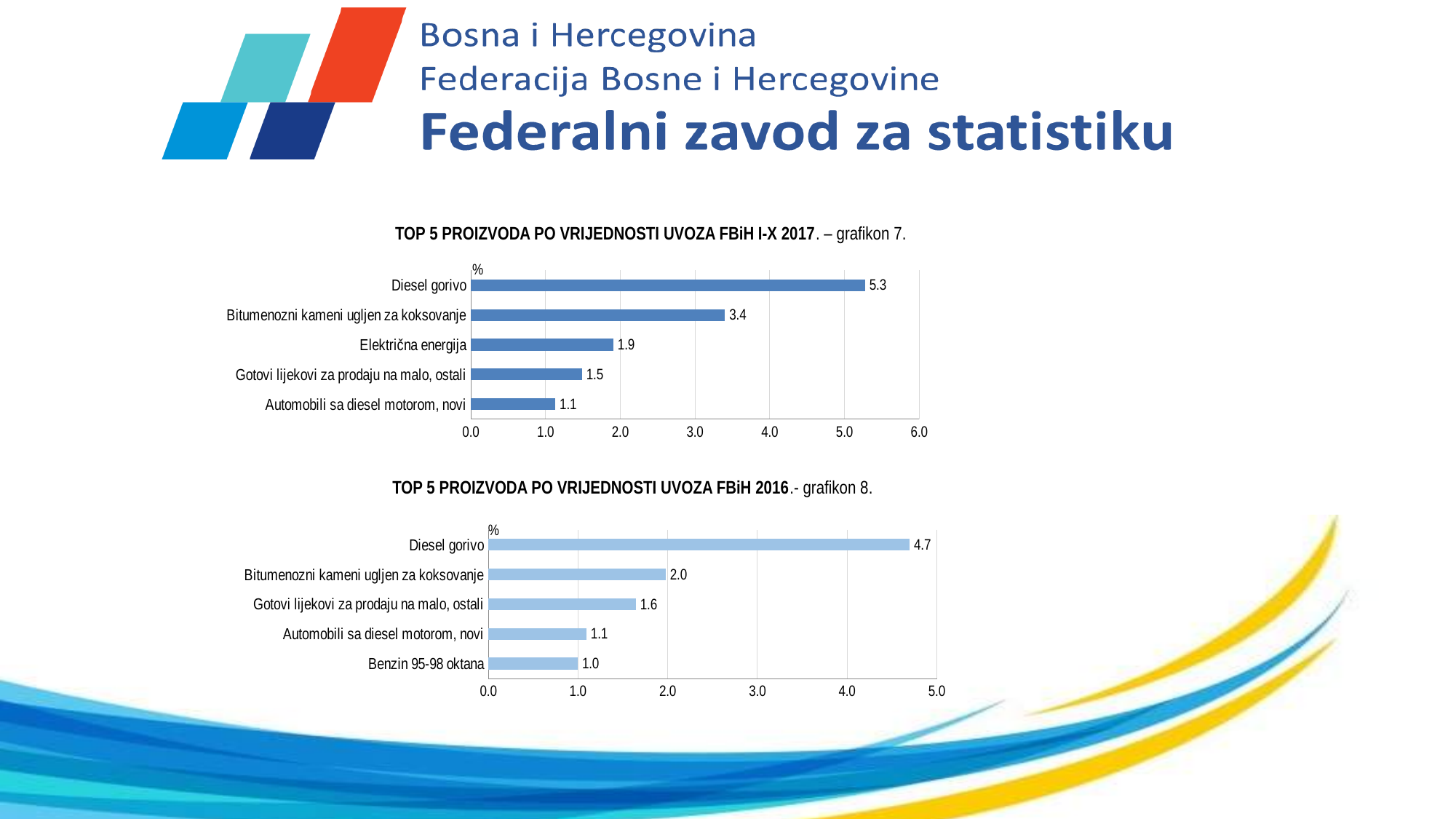
In the 2016 chart (grafikon 8), what is the value for Bitumenozni kameni ugljen za koksovanje? 2.0 What is the title of the lower chart on the slide? TOP 5 PROIZVODA PO VRIJEDNOSTI UVOZA FBiH 2016.- grafikon 8. In the 2017 chart (grafikon 7), what is the value for Električna energija? 1.9 In the 2016 chart (grafikon 8), what is the difference between Gotovi lijekovi za prodaju na malo, ostali and Benzin 95-98 oktana? 0.6 In the 2016 chart (grafikon 8), which category has the highest value? Diesel gorivo In the 2016 chart (grafikon 8), is the value for Diesel gorivo greater or less than 4.0? greater In the 2017 chart (grafikon 7), what is the value for Diesel gorivo? 5.3 In the 2017 chart (grafikon 7), what is the difference between Diesel gorivo and Bitumenozni kameni ugljen za koksovanje? 1.9 In the 2017 chart (grafikon 7), which category has the lowest value? Automobili sa diesel motorom, novi In the 2017 chart (grafikon 7), which is larger: Električna energija or Gotovi lijekovi za prodaju na malo, ostali? Električna energija What kind of chart is the 2016 chart (grafikon 8)? bar chart How many categories are shown in the 2017 chart (grafikon 7)? 5